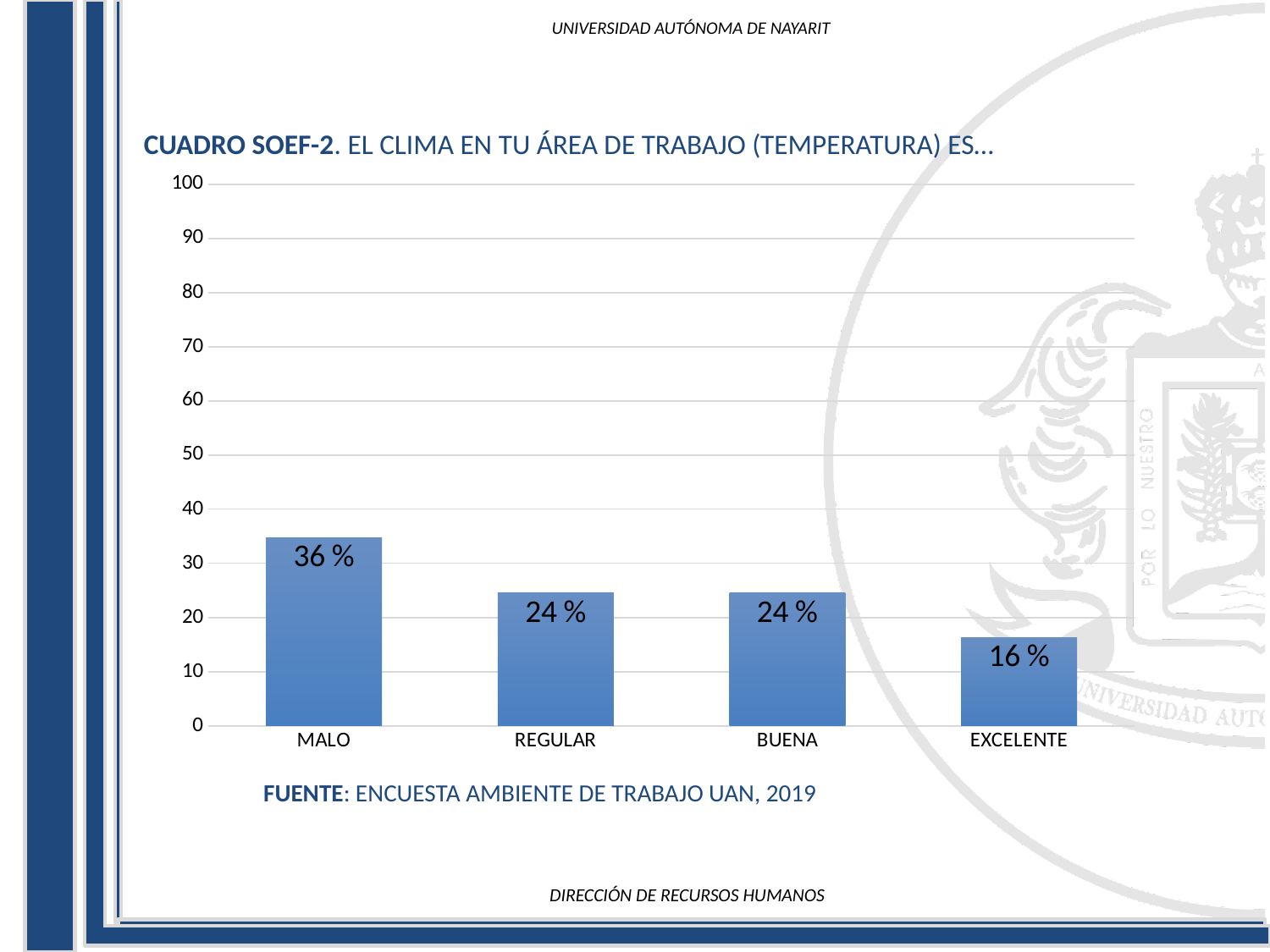
What kind of chart is shown on the slide? bar chart What is the difference between the values for MALO and BUENA? 12 % What is the difference between the values for MALO and EXCELENTE? 20 % What is the value for MALO? 36 % Which is larger, the value for BUENA or the value for EXCELENTE? BUENA What is the source cited below the chart? ENCUESTA AMBIENTE DE TRABAJO UAN, 2019 What is the value for EXCELENTE? 16 % Which category has the highest value? MALO Which category has the lowest value? EXCELENTE What is the value for REGULAR? 24 % How many categories are shown on the x axis? 4 Is the value for MALO greater or less than 30? greater